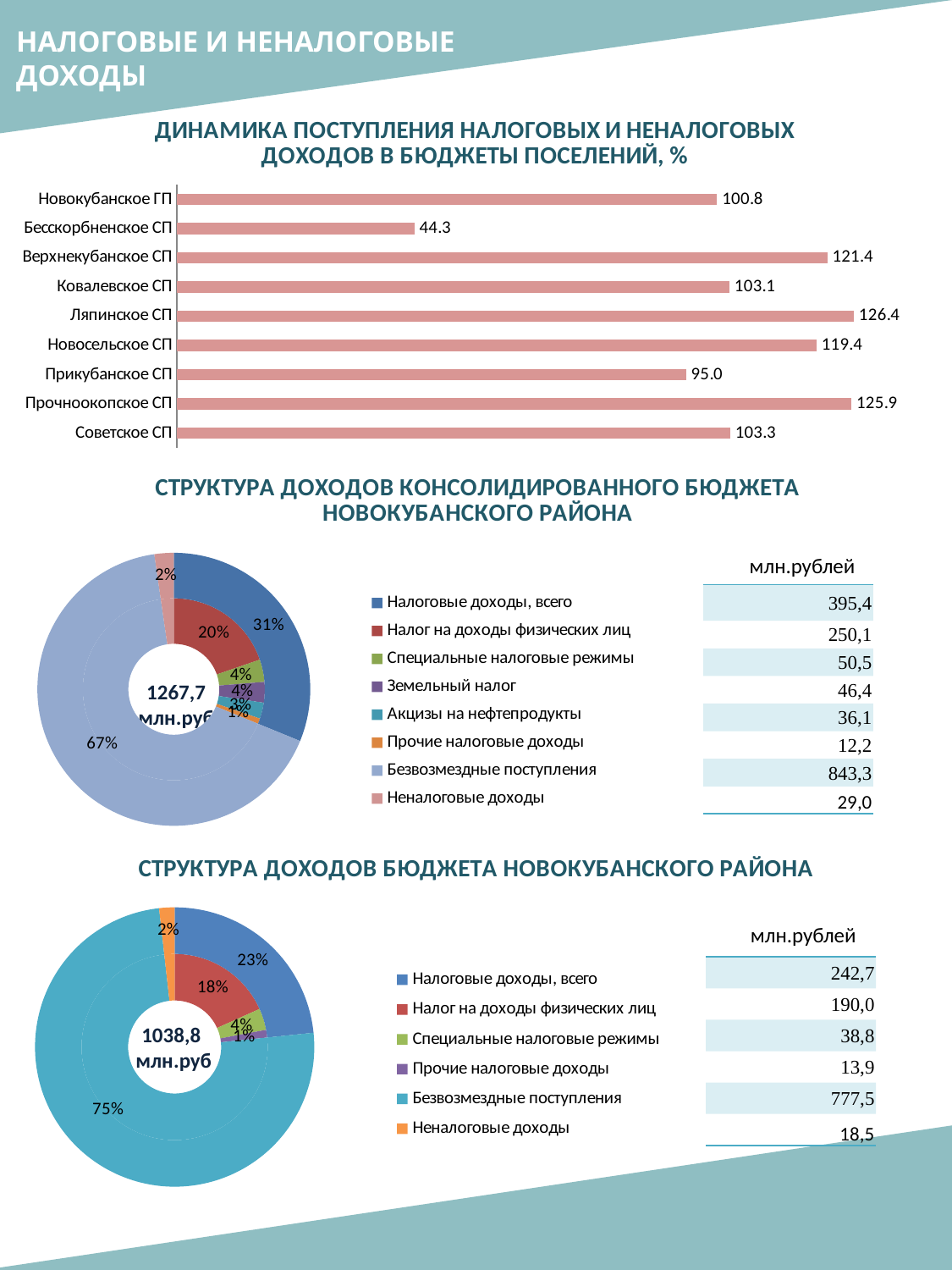
In the doughnut chart 'Структура доходов консолидированного бюджета Новокубанского района', what share is Безвозмездные поступления? 67% In the bar chart 'Динамика поступления налоговых и неналоговых доходов в бюджеты поселений, %', what is the value for Верхнекубанское СП? 121.4 What type of chart is 'Динамика поступления налоговых и неналоговых доходов в бюджеты поселений, %'? bar chart In the bar chart 'Динамика поступления налоговых и неналоговых доходов в бюджеты поселений, %', which settlement has the highest value? Ляпинское СП In the chart 'Структура доходов консолидированного бюджета Новокубанского района', what is the value in млн.рублей for Налог на доходы физических лиц? 250,1 In the bar chart 'Динамика поступления налоговых и неналоговых доходов в бюджеты поселений, %', which is larger: the value for Ковалевское СП or Советское СП? Советское СП What total value is shown in the centre of the doughnut chart 'Структура доходов бюджета Новокубанского района'? 1038,8 млн.руб In the doughnut chart 'Структура доходов бюджета Новокубанского района', what share is Налоговые доходы, всего? 23% How many settlements are shown in the bar chart 'Динамика поступления налоговых и неналоговых доходов в бюджеты поселений, %'? 9 How many entries does the legend list in the chart 'Структура доходов консолидированного бюджета Новокубанского района'? 8 In the bar chart 'Динамика поступления налоговых и неналоговых доходов в бюджеты поселений, %', what is the difference between the values for Новокубанское ГП and Прикубанское СП? 5.8 In the bar chart 'Динамика поступления налоговых и неналоговых доходов в бюджеты поселений, %', which settlement has the lowest value? Бесскорбненское СП